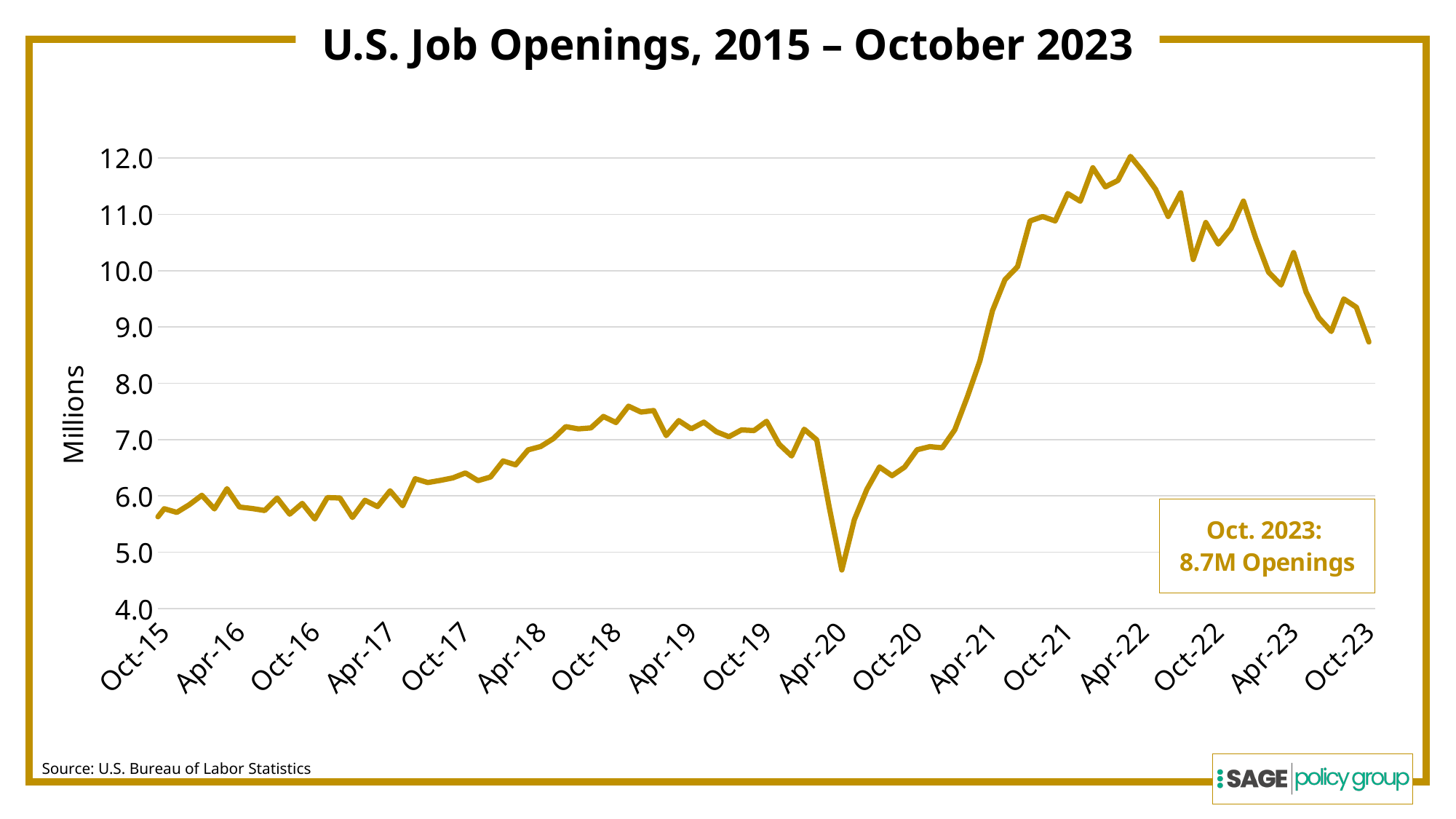
Around which x-axis label does the line reach its lowest point? Apr-20 Is the value for Apr-20 greater or less than 5.0? less Is the value for Apr-23 greater or less than 9.0? greater Is the value for Oct-15 greater or less than 6.0? less What is the title of the chart? U.S. Job Openings, 2015 – October 2023 What kind of chart is shown on the slide? Line chart What is the value of U.S. job openings for October 2023 as labelled on the chart? 8.7M Openings Around which x-axis label does the line reach its highest point? Apr-22 What unit is shown on the y-axis label? Millions Do job openings rise or fall between Apr-22 and Oct-23? fall